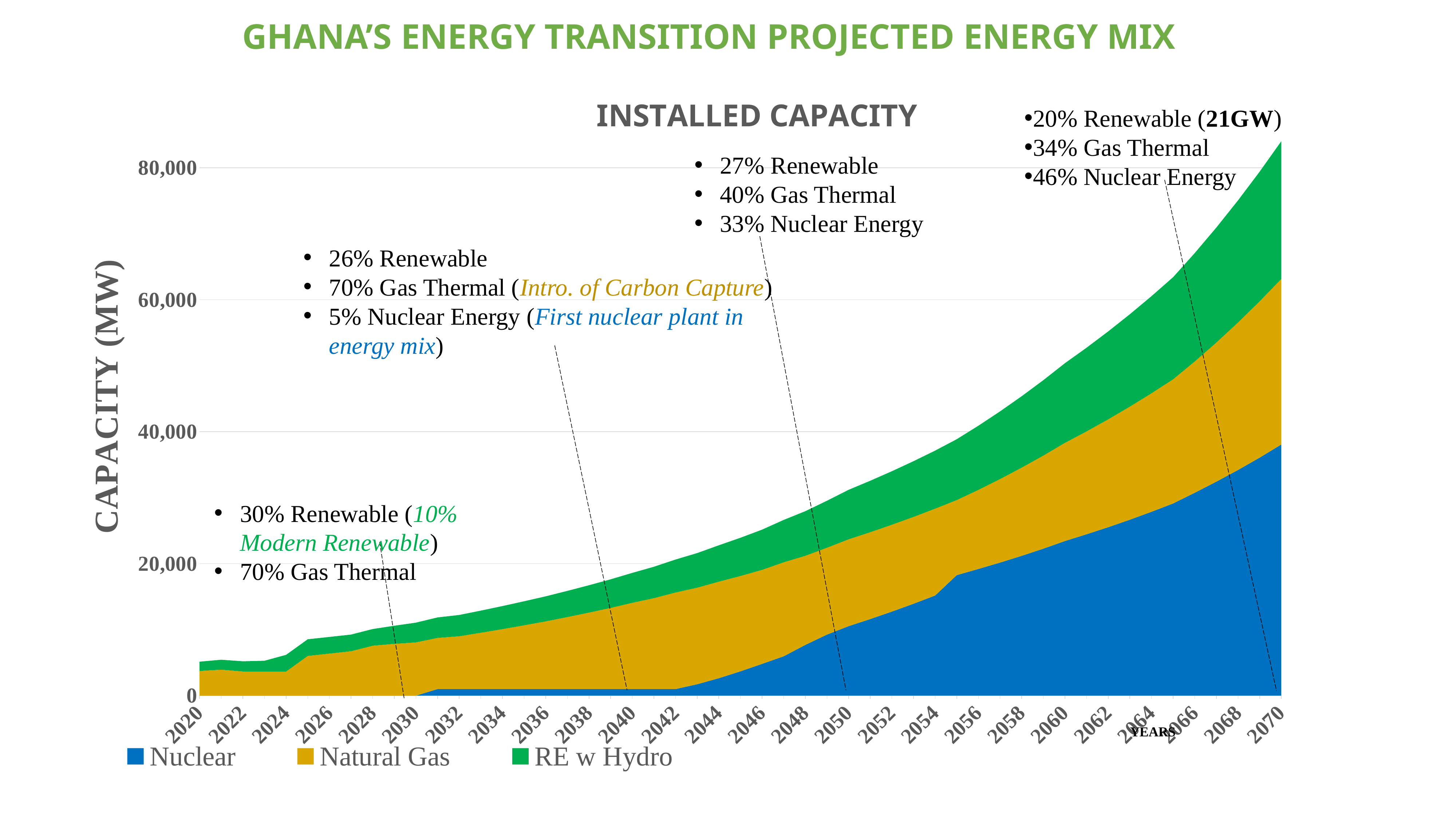
Is the total installed capacity in 2020 greater or less than 20,000? less What kind of chart is shown on the slide? Stacked area chart Which series has the largest capacity in 2070? Nuclear What is the title of the chart on the slide? INSTALLED CAPACITY Is the total installed capacity in 2070 greater or less than 80,000? greater How many year labels are shown on the x axis of the chart? 26 Is the total installed capacity in 2050 greater or less than 20,000? greater How many series does the legend of the Installed Capacity chart list? 3 What are the three series listed in the legend of the Installed Capacity chart? Nuclear, Natural Gas, RE w Hydro Does total installed capacity rise or fall from 2020 to 2070? Rise